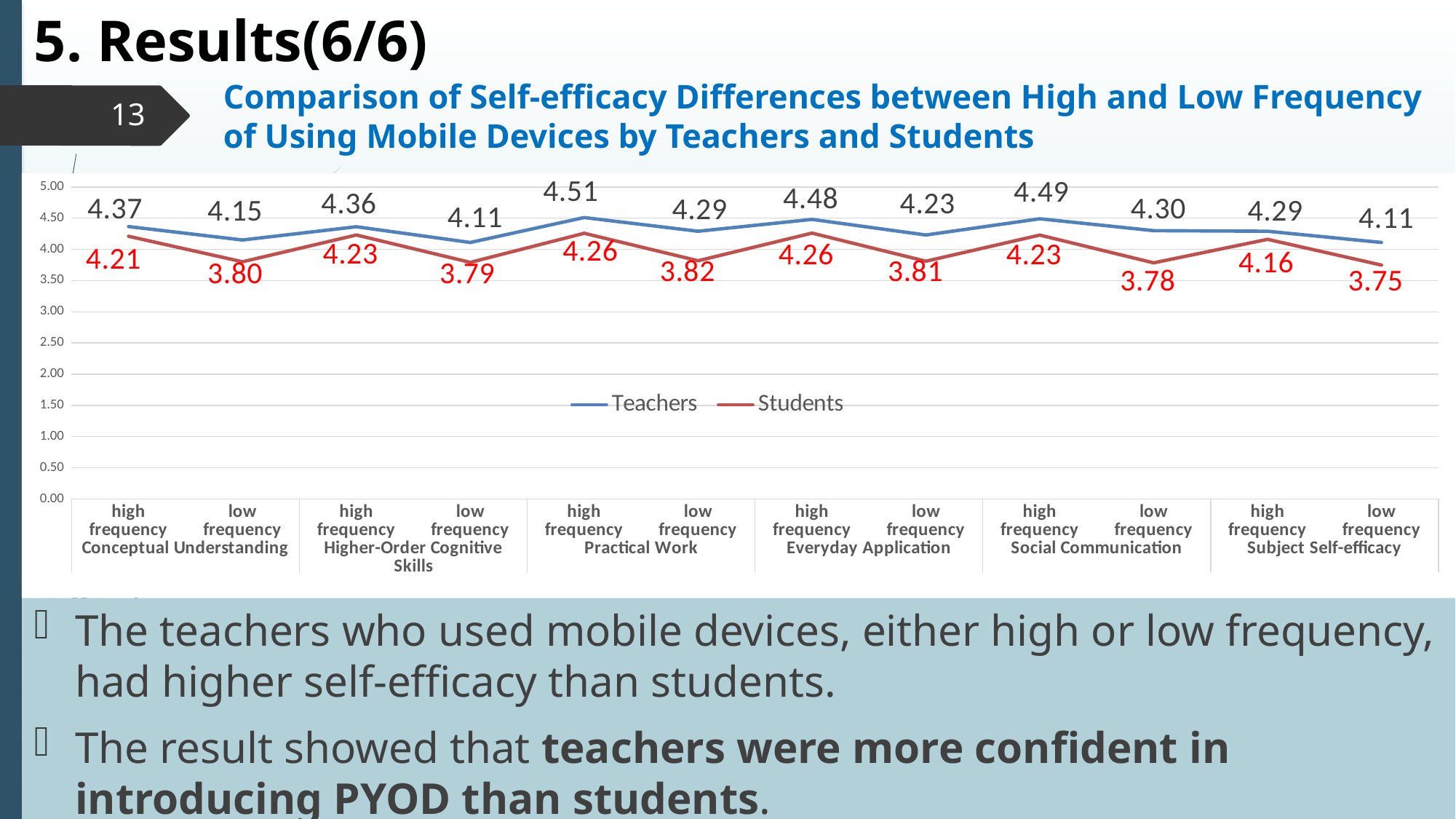
How many series does the legend list? 2 What is the Teachers value for low frequency Conceptual Understanding? 4.15 What is the Students value for high frequency Higher-Order Cognitive Skills? 4.23 How many categories are plotted along the x axis? 12 What is the Teachers value for high frequency Practical Work? 4.51 Is the Students value for low frequency Practical Work greater or less than 4.00? less What is the Students value for low frequency Social Communication? 3.78 At which category does the Teachers series reach its highest value? high frequency Practical Work What is the difference between the Teachers and Students values for low frequency Everyday Application? 0.42 What kind of chart is shown on the slide? line chart Which is larger: the Students value for high frequency Conceptual Understanding or the Students value for low frequency Conceptual Understanding? high frequency Conceptual Understanding At which category does the Students series reach its lowest value? low frequency Subject Self-efficacy